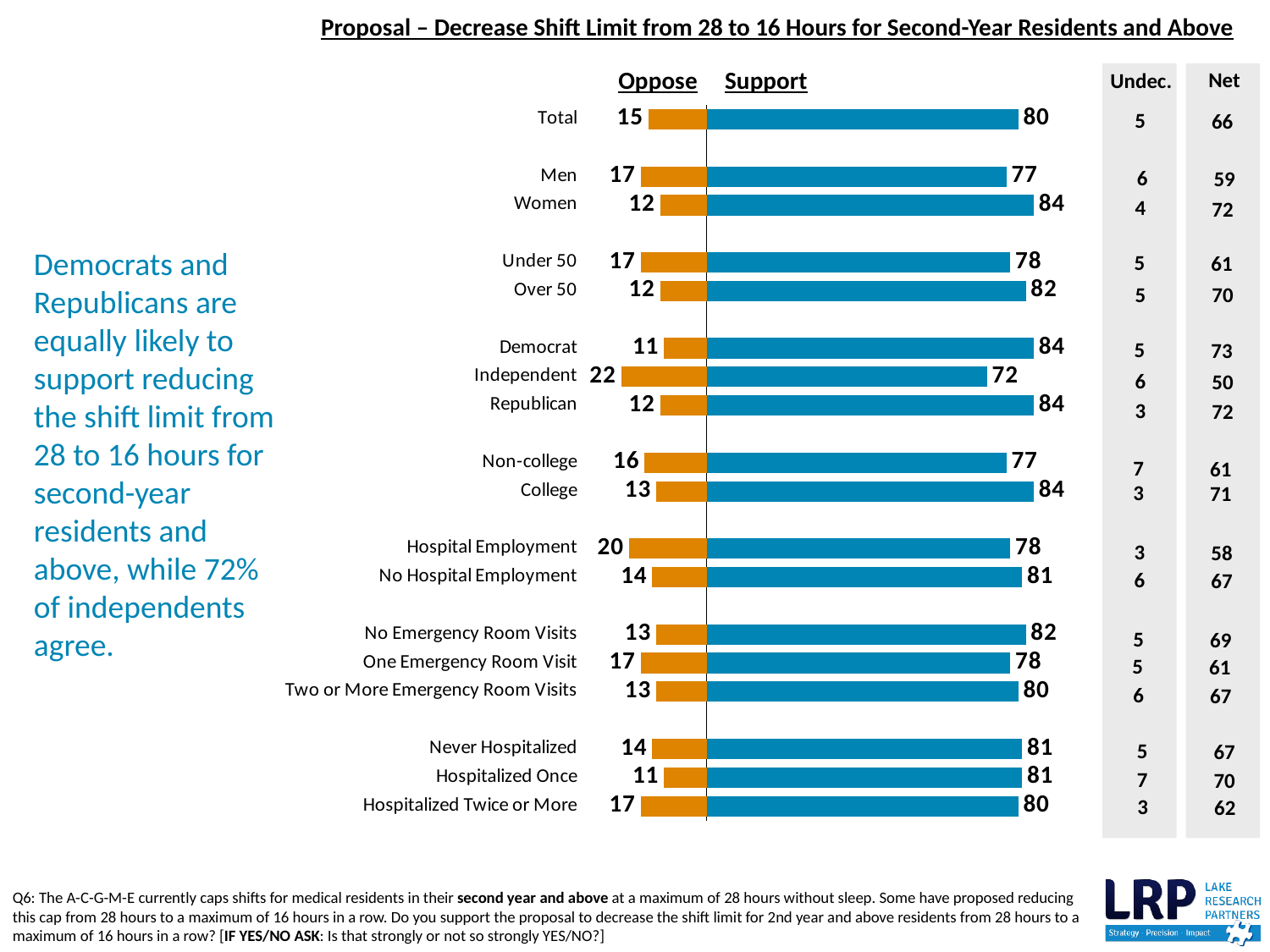
Which group has the highest Oppose value? Independent What is the Support value for Hospital Employment? 78 How many groups are plotted in the chart? 18 What is the Oppose value for Hospitalized Once? 11 What is the difference between the Support and Oppose values for Total? 65 What type of chart is shown on the slide? Bar chart How many series does the chart show? 2 Which group has the lowest Support value? Independent What is the Oppose value for Independent? 22 How much higher is the Support value for Women than for Men? 7 What is the Support value for Total? 80 Which has a higher Support value, Under 50 or Over 50? Over 50